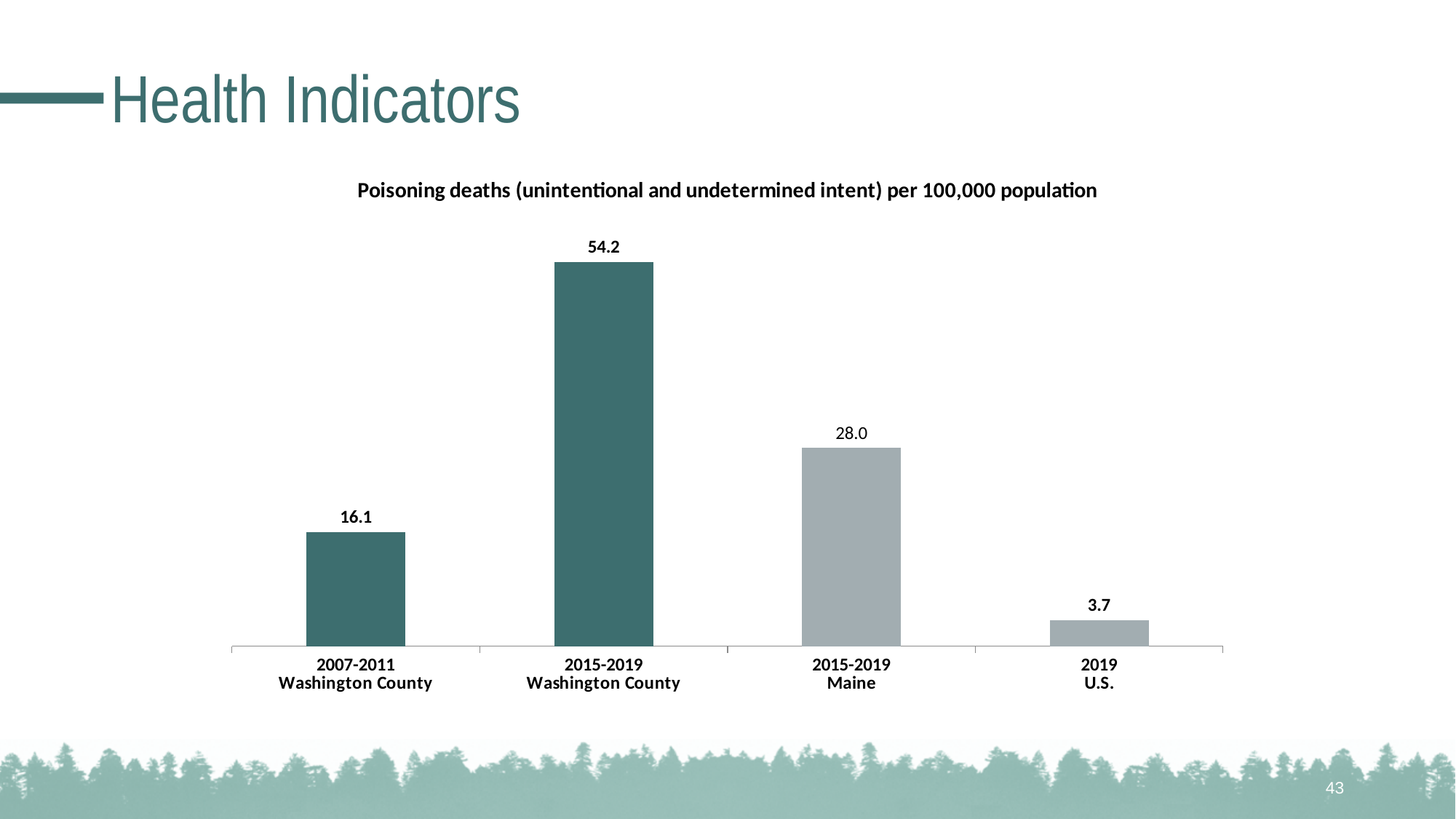
What kind of chart is shown on the slide? Bar chart What is the difference between the 2015-2019 Washington County value and the 2015-2019 Maine value? 26.2 Which category has the lowest value? 2019 U.S. What is the value for 2007-2011 Washington County? 16.1 What is the title of the chart? Poisoning deaths (unintentional and undetermined intent) per 100,000 population What is the value for 2019 U.S.? 3.7 How many bars are shown in the chart? 4 What is the value for 2015-2019 Washington County? 54.2 Which category has the highest value? 2015-2019 Washington County What is the value for 2015-2019 Maine? 28.0 Which is larger, the value for 2015-2019 Maine or the value for 2007-2011 Washington County? 2015-2019 Maine What is the difference between the 2015-2019 Washington County value and the 2007-2011 Washington County value? 38.1